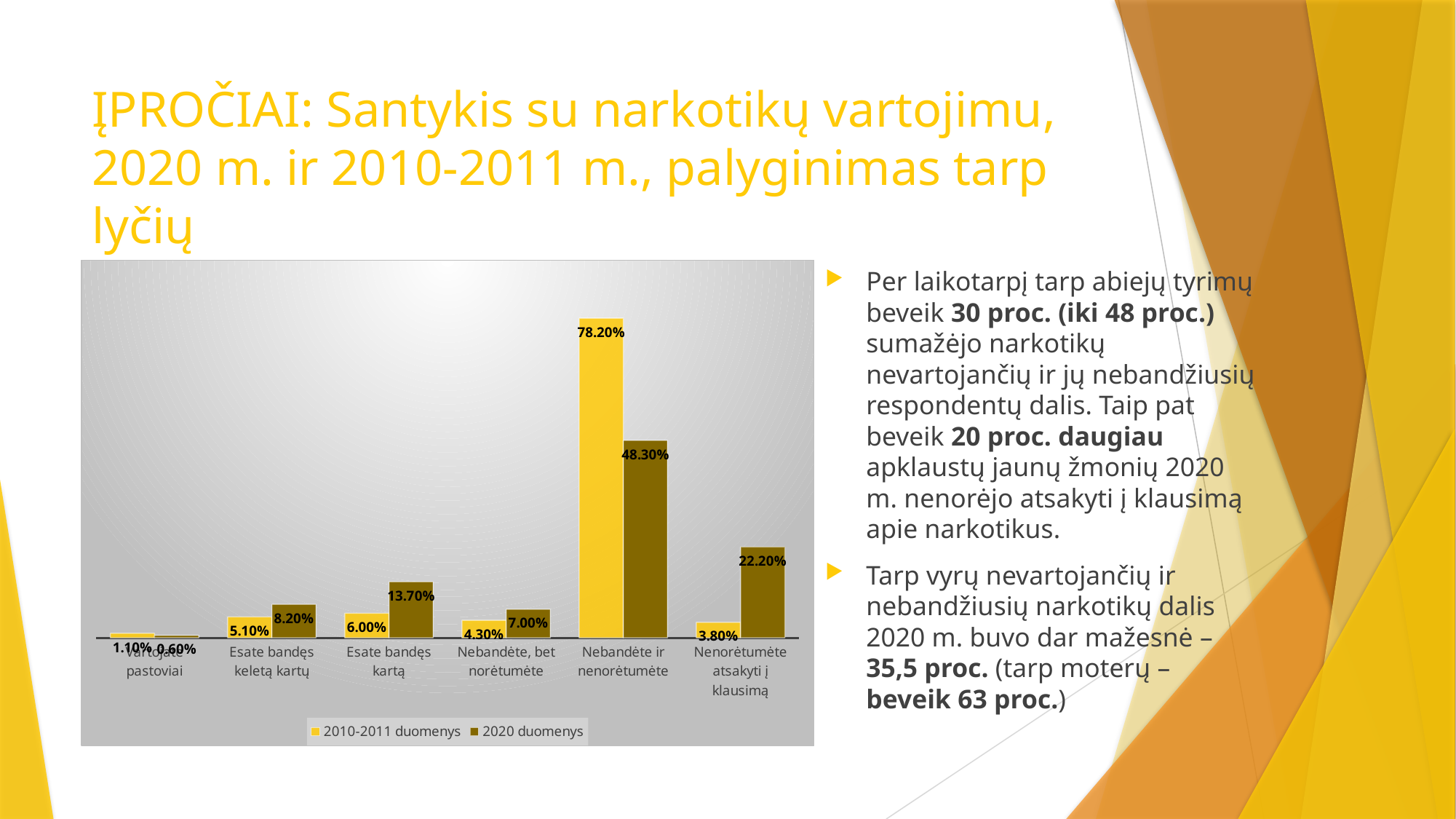
What is the 2010-2011 duomenys value for "Nebandėte ir nenorėtumėte"? 78.20% Which category has the highest 2020 duomenys value? Nebandėte ir nenorėtumėte What is the 2010-2011 duomenys value for "Esate bandęs kartą"? 6.00% For "Esate bandęs keletą kartų", which series has the larger value, 2010-2011 duomenys or 2020 duomenys? 2020 duomenys How many categories are shown on the x axis of the chart? 6 What is the 2020 duomenys value for "Nebandėte, bet norėtumėte"? 7.00% What is the 2020 duomenys value for "Nenorėtumėte atsakyti į klausimą"? 22.20% What kind of chart is shown on the slide? bar chart What is the difference between the 2020 duomenys and 2010-2011 duomenys values for "Nenorėtumėte atsakyti į klausimą"? 18.40% What is the 2020 duomenys value for "Nebandėte ir nenorėtumėte"? 48.30% How many series does the chart legend list? 2 What is the difference between the 2010-2011 duomenys and 2020 duomenys values for "Nebandėte ir nenorėtumėte"? 29.90%